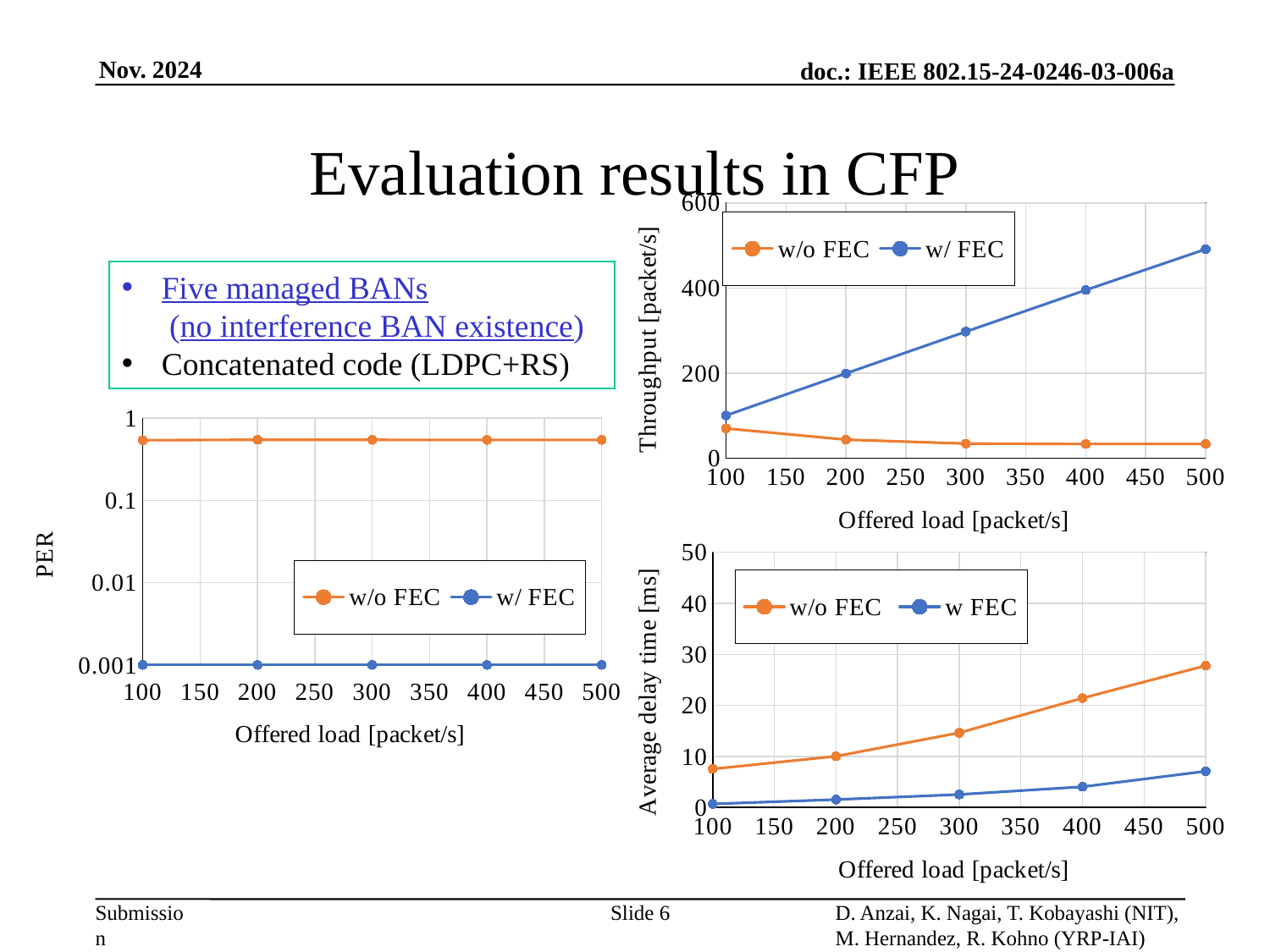
On the Throughput chart (top right), is the w/o FEC value at an offered load of 100 greater or less than 200? less On the Average delay time chart (bottom right), at an offered load of 400, which series has the larger delay, w/o FEC or w FEC? w/o FEC On the PER chart (left), is the w/o FEC value at an offered load of 300 greater or less than 0.1? greater On the Average delay time chart (bottom right), how many offered-load points are plotted for the w/o FEC series? 5 On the Throughput chart (top right), is the w/ FEC value at an offered load of 500 greater or less than 400? greater On the Throughput chart (top right), how many series does the legend list? 2 On the Throughput chart (top right), does the w/ FEC series rise or fall as offered load increases? rise On the PER chart (left), what kind of chart is it? line chart On the Throughput chart (top right), at an offered load of 500, which series has the larger throughput, w/o FEC or w/ FEC? w/ FEC On the Throughput chart (top right), does the w/o FEC series rise or fall as offered load increases? fall